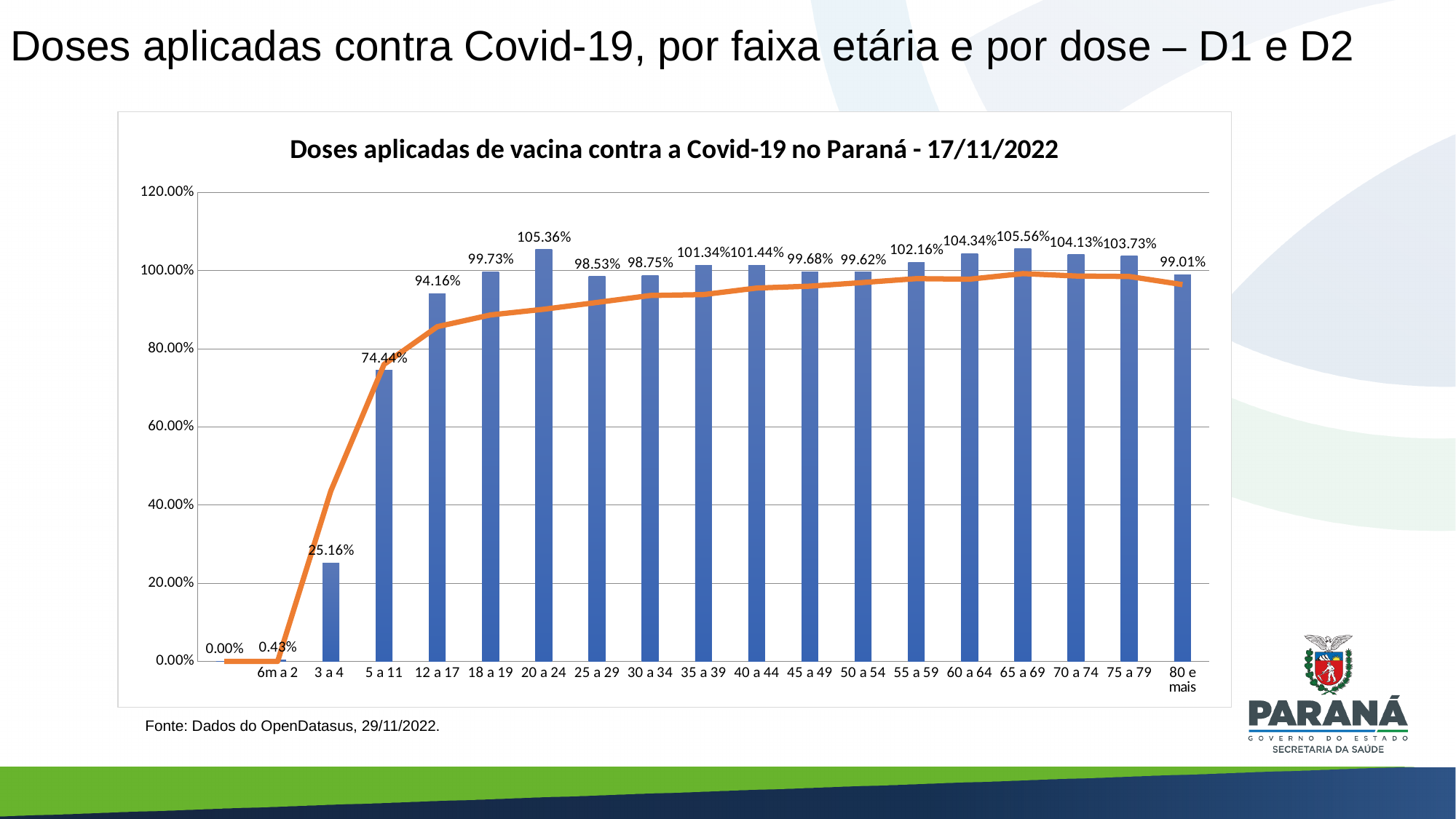
What is the difference between the values for 18 a 19 and 12 a 17? 5.57% Do the bar values generally rise or fall from 6m a 2 to 18 a 19? rise What is the title of the chart? Doses aplicadas de vacina contra a Covid-19 no Paraná - 17/11/2022 Is the orange line value for the 5 a 11 age group greater or less than 80.00%? less What is the difference between the values for 65 a 69 and 20 a 24? 0.20% What kind of chart is shown on the slide? Bar chart with a line What is the value shown for the 80 e mais age group? 99.01% What is the value shown for the 5 a 11 age group? 74.44% What is the value shown for the 20 a 24 age group? 105.36% Which is larger, the value for 60 a 64 or the value for 55 a 59? 60 a 64 Which age group has the highest bar value? 65 a 69 What is the value shown for the 3 a 4 age group? 25.16%